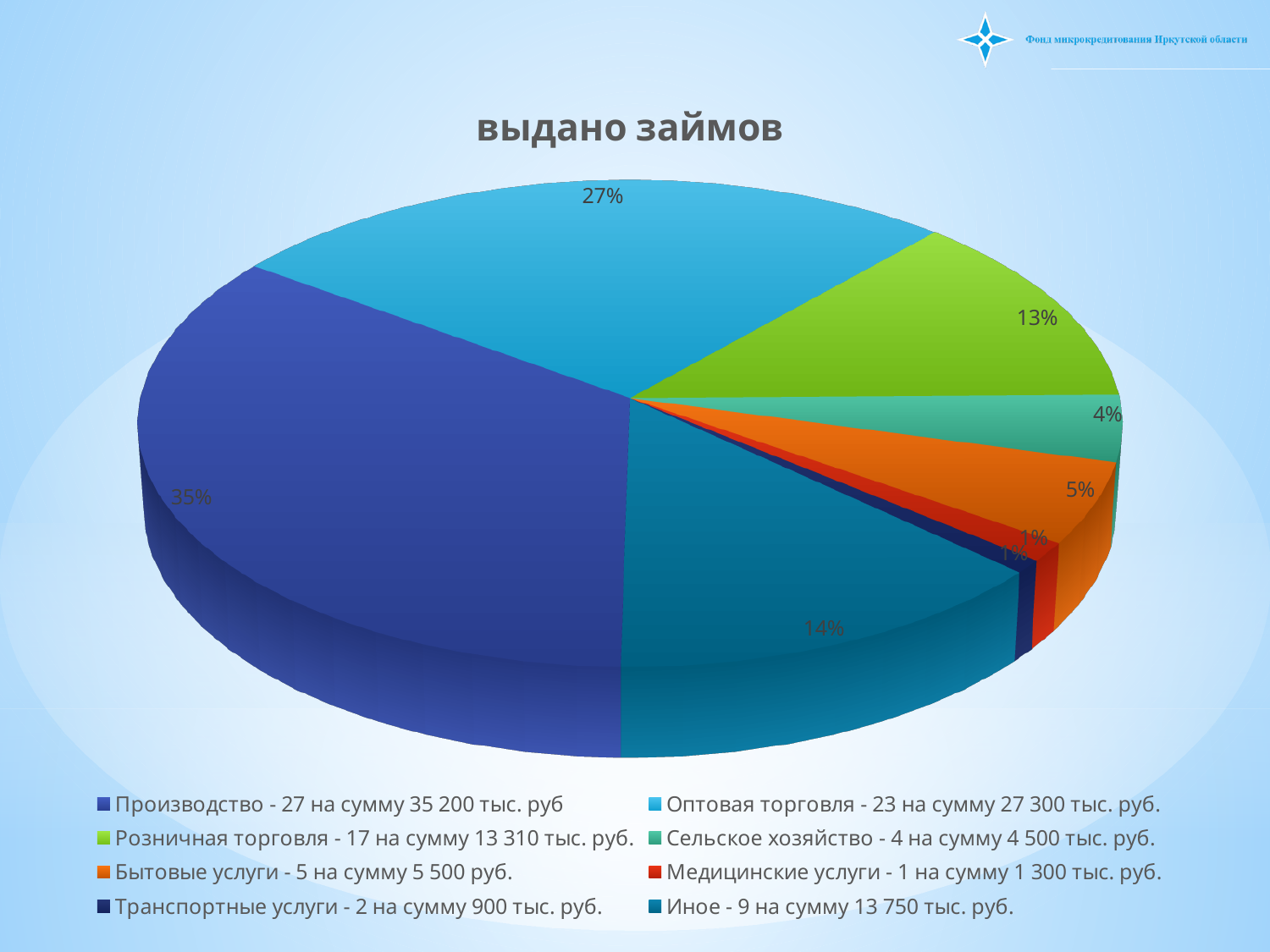
According to the legend, how many loans were issued for Сельское хозяйство? 4 What kind of chart is shown on the slide? pie chart How many entries does the legend list? 8 How many slices does the pie chart have? 8 What is the title of the chart? выдано займов Which category has the largest slice of the pie? Производство What share of the pie does Оптовая торговля have? 27% What is the difference in percentage points between the Производство slice and the Оптовая торговля slice? 8 What share of the pie does Розничная торговля have? 13% What share of the pie does Иное have? 14% Which is larger, the slice for Оптовая торговля or the slice for Розничная торговля? Оптовая торговля